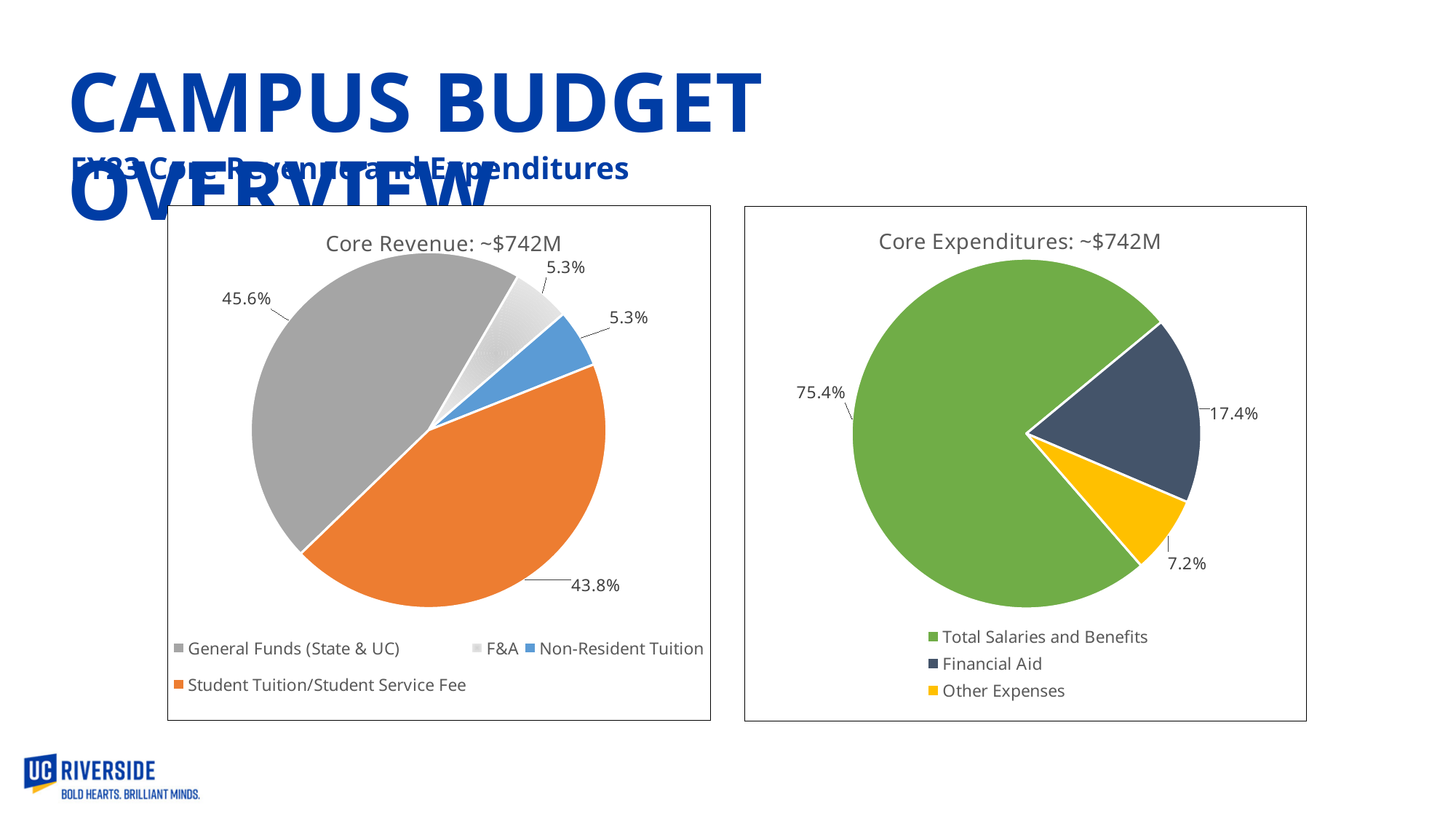
In the Core Expenditures chart, what share does Financial Aid have? 17.4% In the Core Revenue chart, what share does General Funds (State & UC) have? 45.6% In the Core Expenditures chart, what share does Other Expenses have? 7.2% How many categories does the legend of the Core Revenue chart list? 4 In the Core Expenditures chart, which category has the smallest slice? Other Expenses In the Core Revenue chart, what is the difference between the General Funds (State & UC) share and the Student Tuition/Student Service Fee share? 1.8% What kind of chart is the Core Expenditures chart? Pie chart In the Core Expenditures chart, what is the difference between the Financial Aid share and the Other Expenses share? 10.2% In the Core Expenditures chart, which category has the largest slice? Total Salaries and Benefits